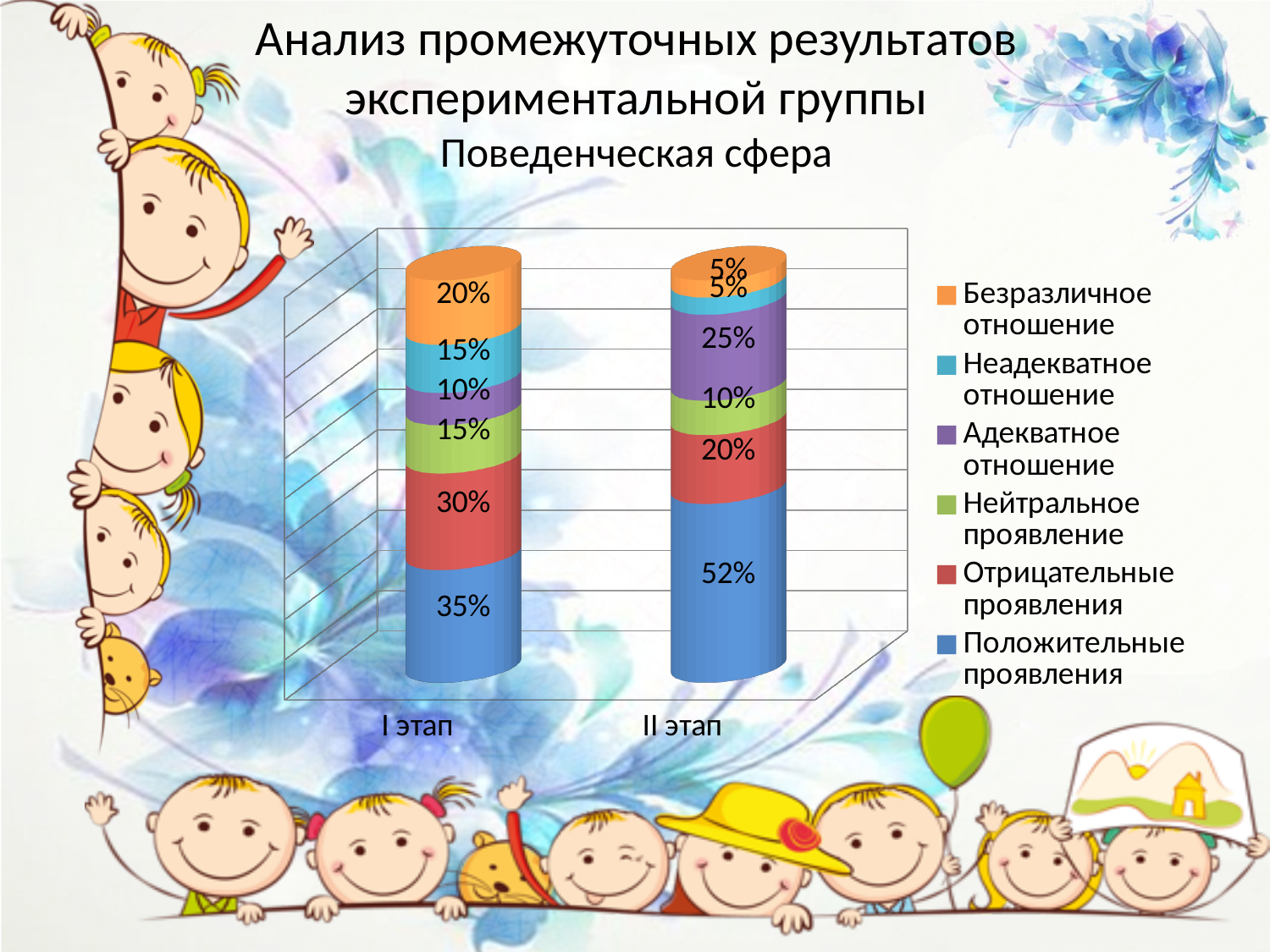
What is the value for Положительные проявления at I этап? 35% How many series does the legend list? 6 By how many percentage points did Положительные проявления change from I этап to II этап? 17 What is the value for Безразличное отношение at I этап? 20% What is the value for Положительные проявления at II этап? 52% Which series has the largest segment at II этап? Положительные проявления What is the value for Нейтральное проявление at I этап? 15% What is the value for Адекватное отношение at II этап? 25% What is the value for Отрицательные проявления at II этап? 20% What kind of chart is shown on the slide? Stacked bar chart Which stage has the larger value for Отрицательные проявления, I этап or II этап? I этап How many categories are shown on the x axis? 2